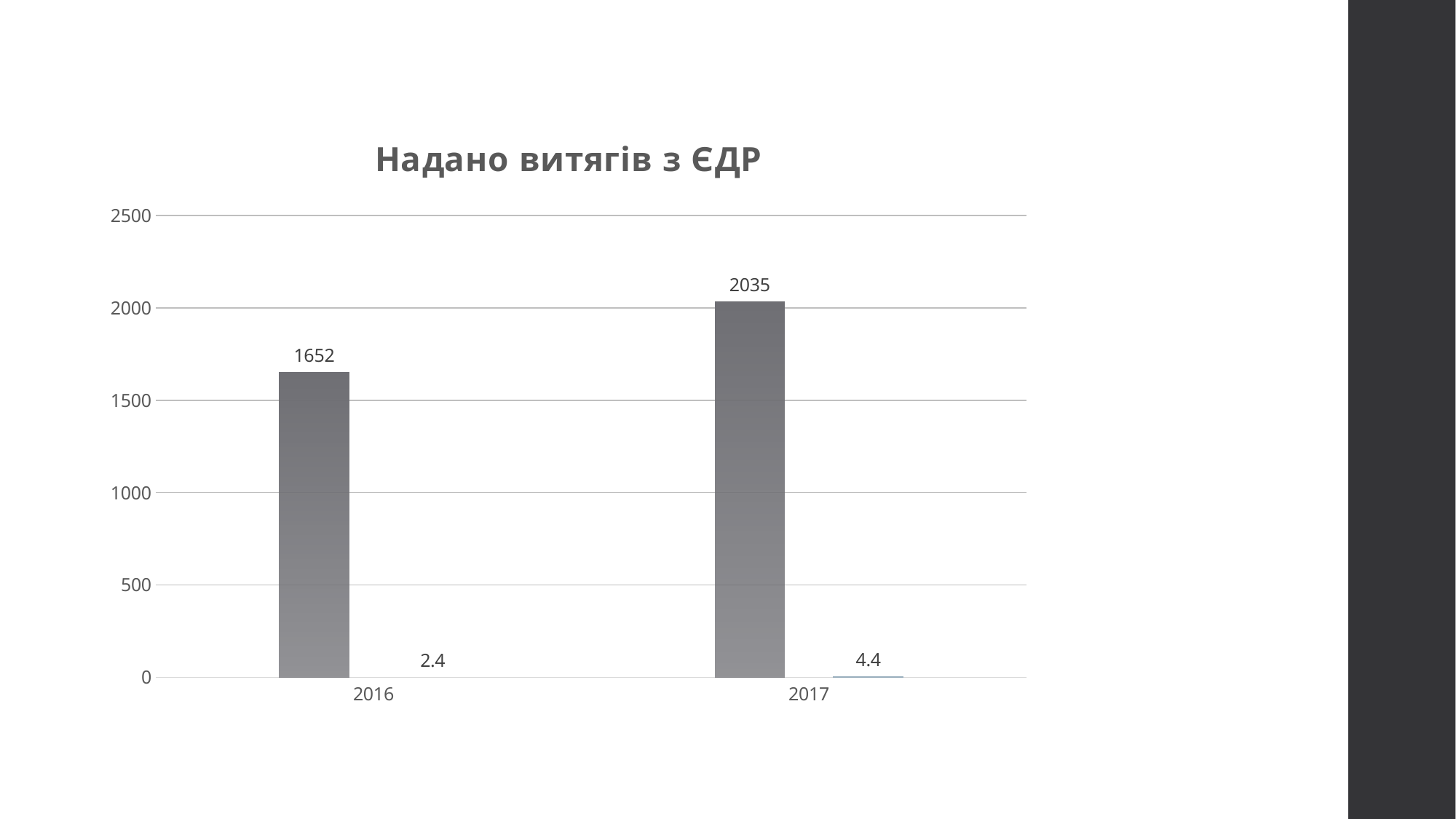
What is the value of the tall grey bar for 2017? 2035 What is the difference between the tall grey bar values for 2017 and 2016? 383 Which year has the higher value for the tall grey bars? 2017 What is the value of the tall grey bar for 2016? 1652 Do the tall grey bar values rise or fall from 2016 to 2017? rise Is the tall grey bar for 2016 greater or less than 1500? greater What is the value of the small second bar for 2016? 2.4 What is the value of the small second bar for 2017? 4.4 What kind of chart is shown on the slide? bar chart How many years are shown on the x axis? 2 What is the difference between the small second bar values for 2017 and 2016? 2 What is the chart's title? Надано витягів з ЄДР